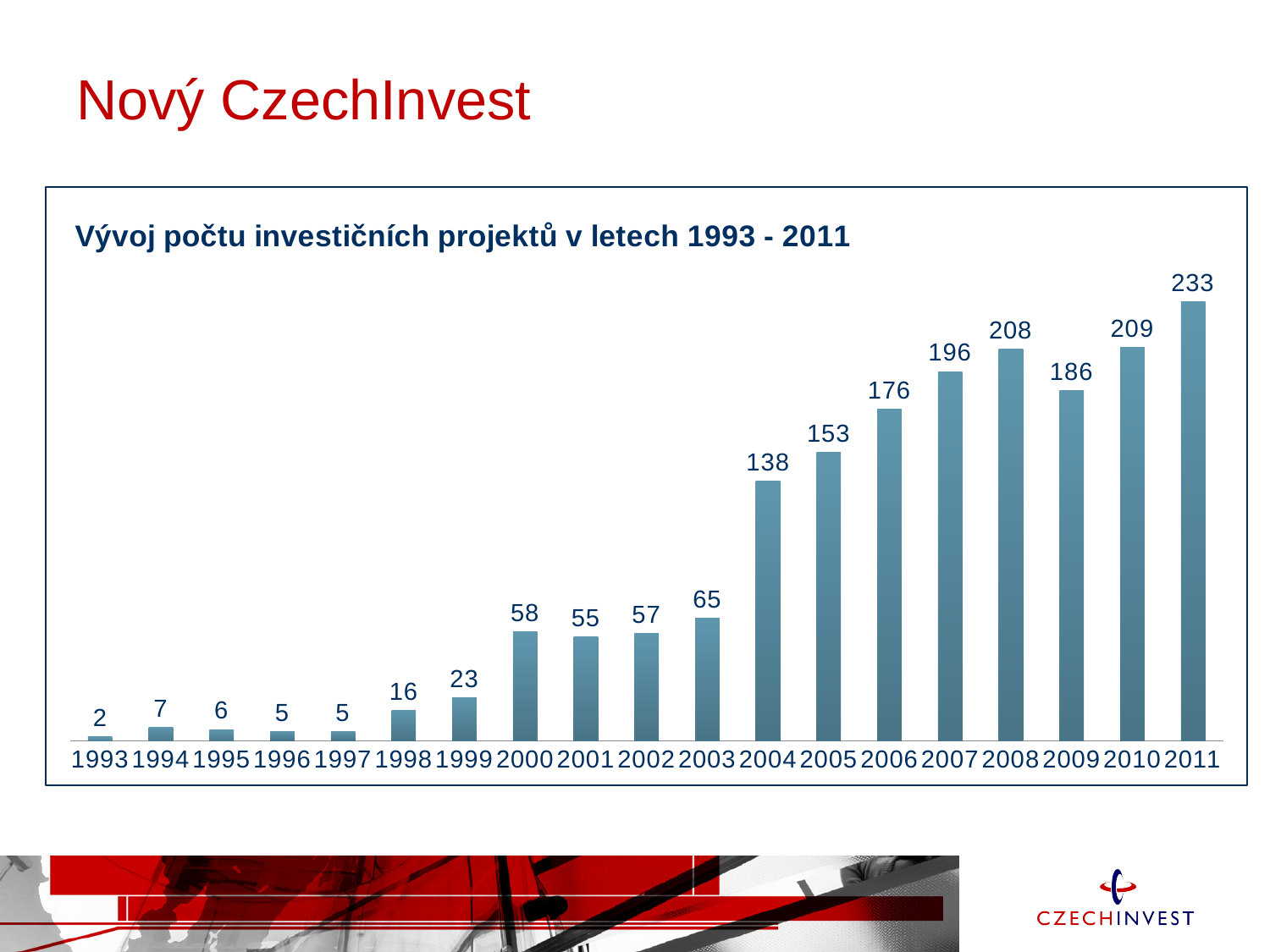
Which year has the lowest value? 1993 Which is larger, the value for 2008 or the value for 2009? 2008 What is the value for 2004? 138 What is the value for 2009? 186 Which year has the highest value? 2011 Do the values generally rise or fall from 1993 to 2011? rise What is the difference between the values for 2004 and 2003? 73 What is the value for 1999? 23 What is the title of the chart? Vývoj počtu investičních projektů v letech 1993 - 2011 What kind of chart is this? bar chart What is the difference between the values for 2011 and 2010? 24 How many years are shown on the x axis? 19